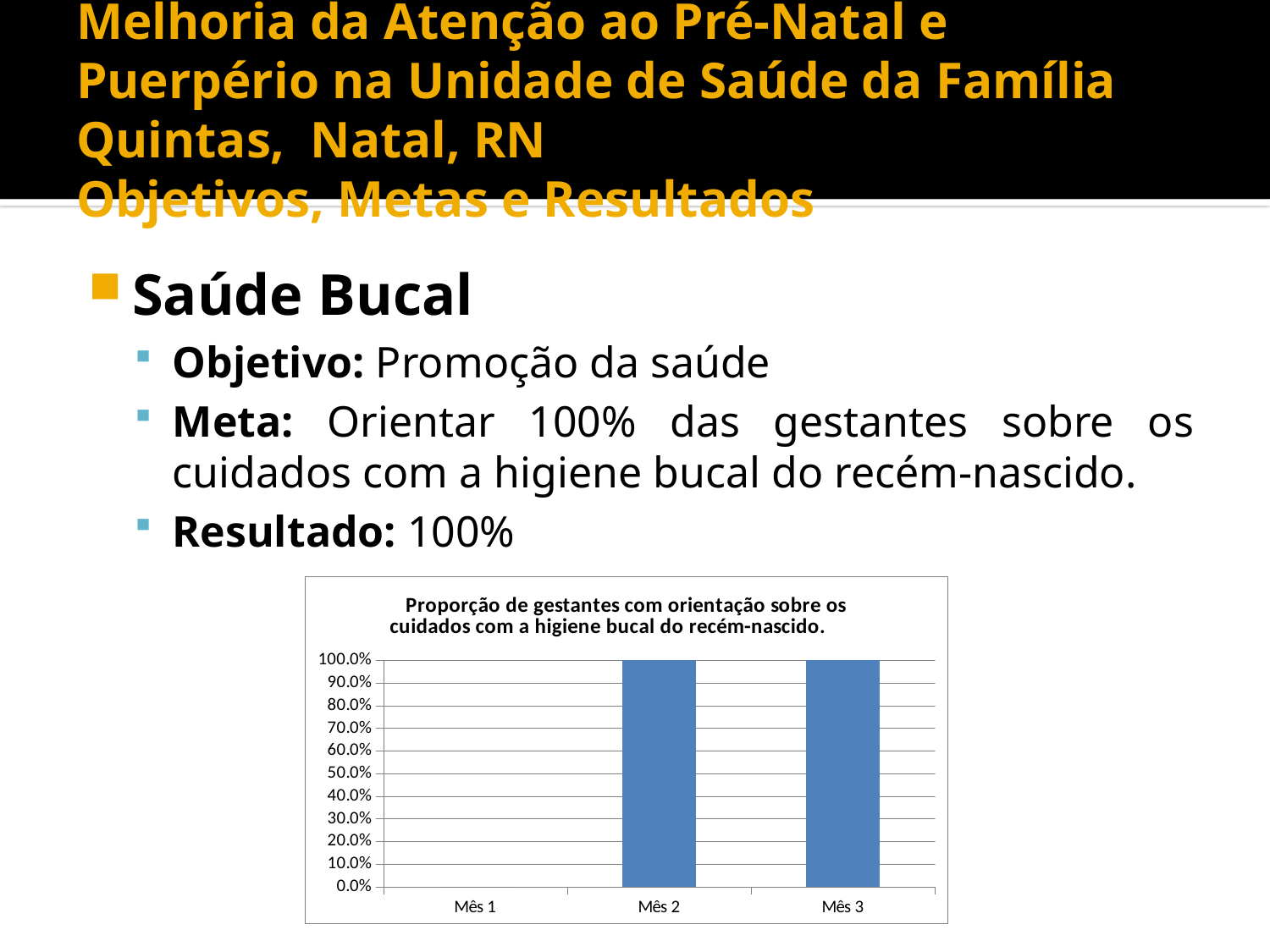
What is the highest value shown on the y axis of the chart? 100.0% How many categories are shown on the x axis of the chart? 3 Do the values rise or fall from Mês 1 to Mês 2? rise What is the value for Mês 2? 100.0% Which category has the lowest value? Mês 1 What is the title of the chart? Proporção de gestantes com orientação sobre os cuidados com a higiene bucal do recém-nascido. Which is larger, the value for Mês 1 or the value for Mês 2? Mês 2 What is the difference between the value for Mês 2 and the value for Mês 1? 100.0% Is the value for Mês 3 greater or less than 50.0%? greater What is the value for Mês 1? 0.0% What kind of chart is shown on the slide? bar chart What is the value for Mês 3? 100.0%